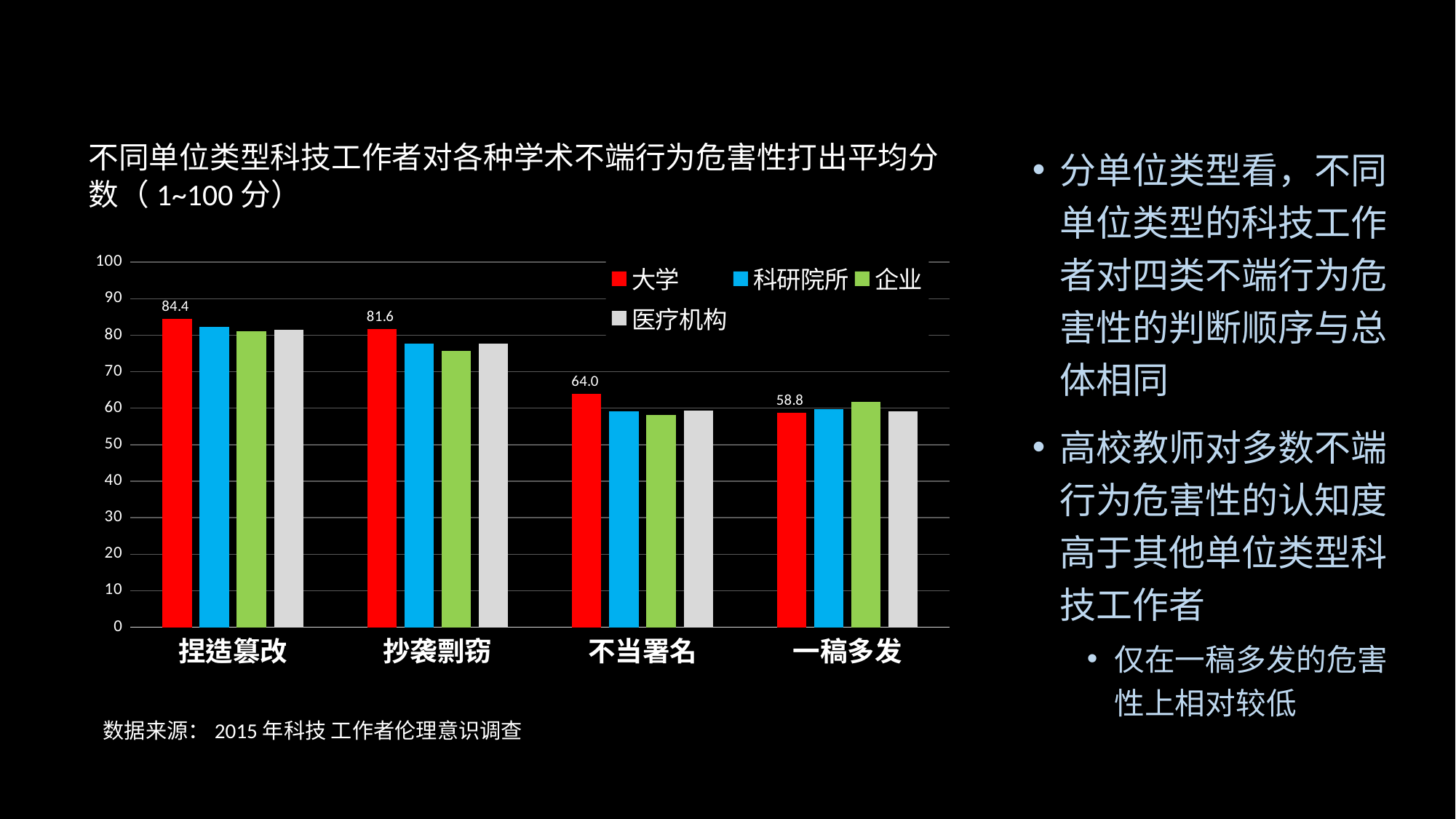
What is the value for 大学 in the 捏造篡改 category? 84.4 What is the value for 大学 in the 不当署名 category? 64.0 What kind of chart is shown on the slide? bar chart What is the difference between the 大学 values for 捏造篡改 and 抄袭剽窃? 2.8 In the 不当署名 category, which is larger: 大学 or 科研院所? 大学 Is the value for 医疗机构 in the 抄袭剽窃 category greater or less than 70? greater For the 大学 series, which category has the highest value? 捏造篡改 What is the difference between the 大学 values for 捏造篡改 and 一稿多发? 25.6 What is the value for 大学 in the 一稿多发 category? 58.8 How many categories are shown on the x axis? 4 How many series does the legend list? 4 For the 大学 series, which category has the lowest value? 一稿多发